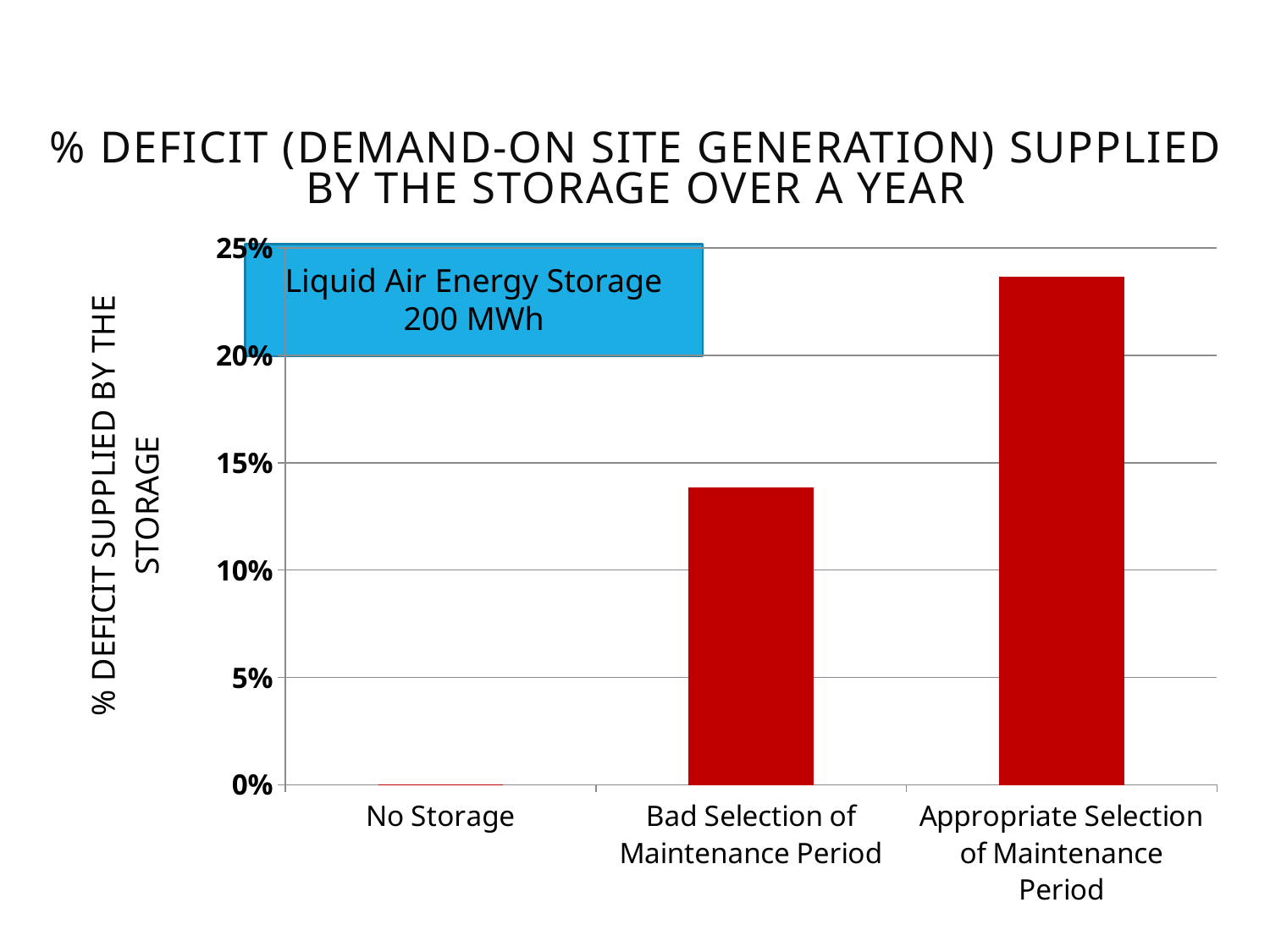
How many categories are shown on the x axis of the chart? 3 What is the % deficit supplied by the storage for No Storage? 0% Is the value for Appropriate Selection of Maintenance Period greater or less than 25%? less Which category has the highest % deficit supplied by the storage? Appropriate Selection of Maintenance Period What is the label on the vertical axis of the chart? % DEFICIT SUPPLIED BY THE STORAGE Which category has the lowest % deficit supplied by the storage? No Storage What kind of chart is shown on the slide? Bar chart What storage capacity is stated in the blue text box on the chart? 200 MWh Which is larger: the value for Bad Selection of Maintenance Period or the value for Appropriate Selection of Maintenance Period? Appropriate Selection of Maintenance Period Is the value for Bad Selection of Maintenance Period greater or less than 15%? less Is the value for Bad Selection of Maintenance Period greater or less than 10%? greater